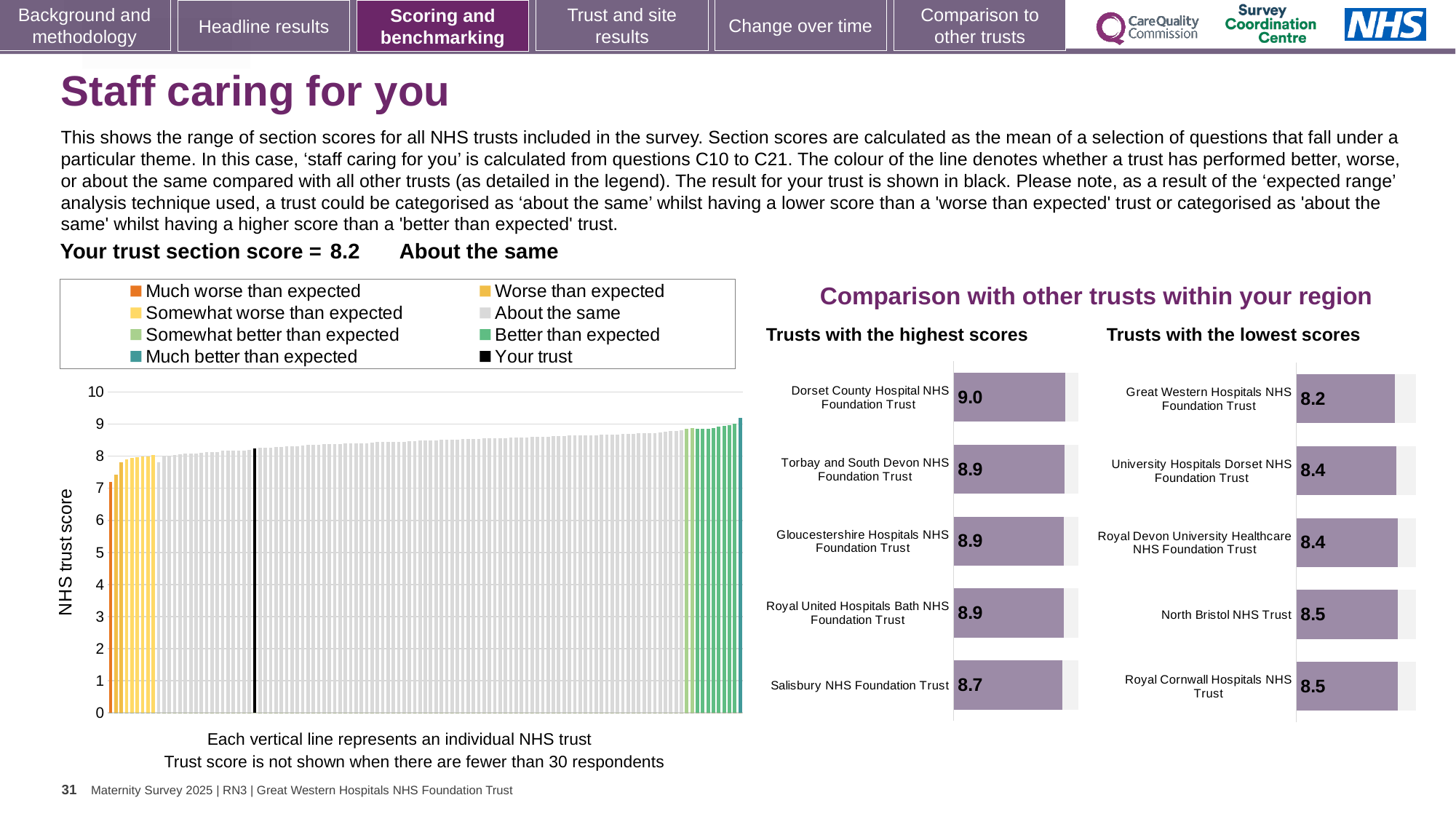
In the 'Trusts with the highest scores' chart, what is the score for Salisbury NHS Foundation Trust? 8.7 In the 'Trusts with the highest scores' chart, what is the score for Dorset County Hospital NHS Foundation Trust? 9.0 In the 'Trusts with the highest scores' chart, what is the difference between the scores of Dorset County Hospital NHS Foundation Trust and Salisbury NHS Foundation Trust? 0.3 In the 'Trusts with the lowest scores' chart, what is the score for North Bristol NHS Trust? 8.5 In the 'Trusts with the highest scores' chart, which trust has the highest score? Dorset County Hospital NHS Foundation Trust In the main 'NHS trust score' chart, is the value of the leftmost (orange) bar greater or less than 8? less What kind of chart is the main 'NHS trust score' chart on the left? Bar chart In the 'Trusts with the lowest scores' chart, which trust has the lowest score? Great Western Hospitals NHS Foundation Trust Which is larger: the score for Torbay and South Devon NHS Foundation Trust in the highest scores chart, or the score for University Hospitals Dorset NHS Foundation Trust in the lowest scores chart? Torbay and South Devon NHS Foundation Trust How many entries does the legend of the main 'NHS trust score' chart list? 8 In the 'Trusts with the lowest scores' chart, what is the difference between the scores of Royal Cornwall Hospitals NHS Trust and Great Western Hospitals NHS Foundation Trust? 0.3 How many trusts are shown in the 'Trusts with the lowest scores' chart? 5